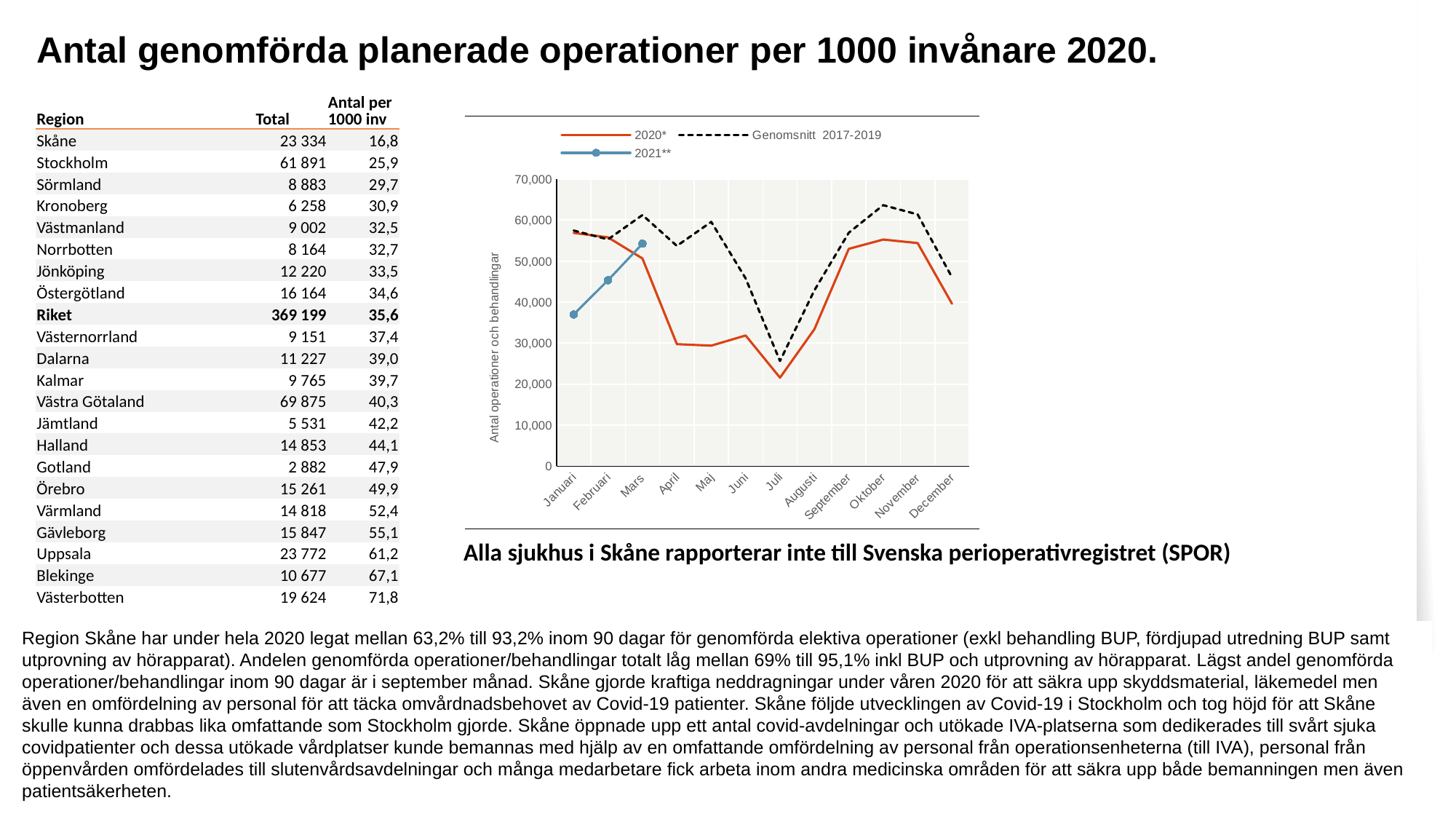
How many series does the chart legend list? 3 How many data points does the 2021** series have in the chart? 3 What kind of chart is shown on the slide? line chart In which month is the Genomsnitt 2017-2019 series at its highest in the chart? Oktober In which month is the 2020* series at its lowest in the chart? Juli Is the value for the Genomsnitt 2017-2019 series in Oktober greater or less than 60,000? greater Is the value for the 2021** series in Januari greater or less than 40,000? less How many months are shown on the x axis of the chart? 12 What is the label on the y axis of the chart? Antal operationer och behandlingar Does the 2021** series rise or fall from Januari to Mars? rise In April, which series has the larger value: 2020* or Genomsnitt 2017-2019? Genomsnitt 2017-2019 Is the value for the 2020* series in Juli greater or less than 30,000? less